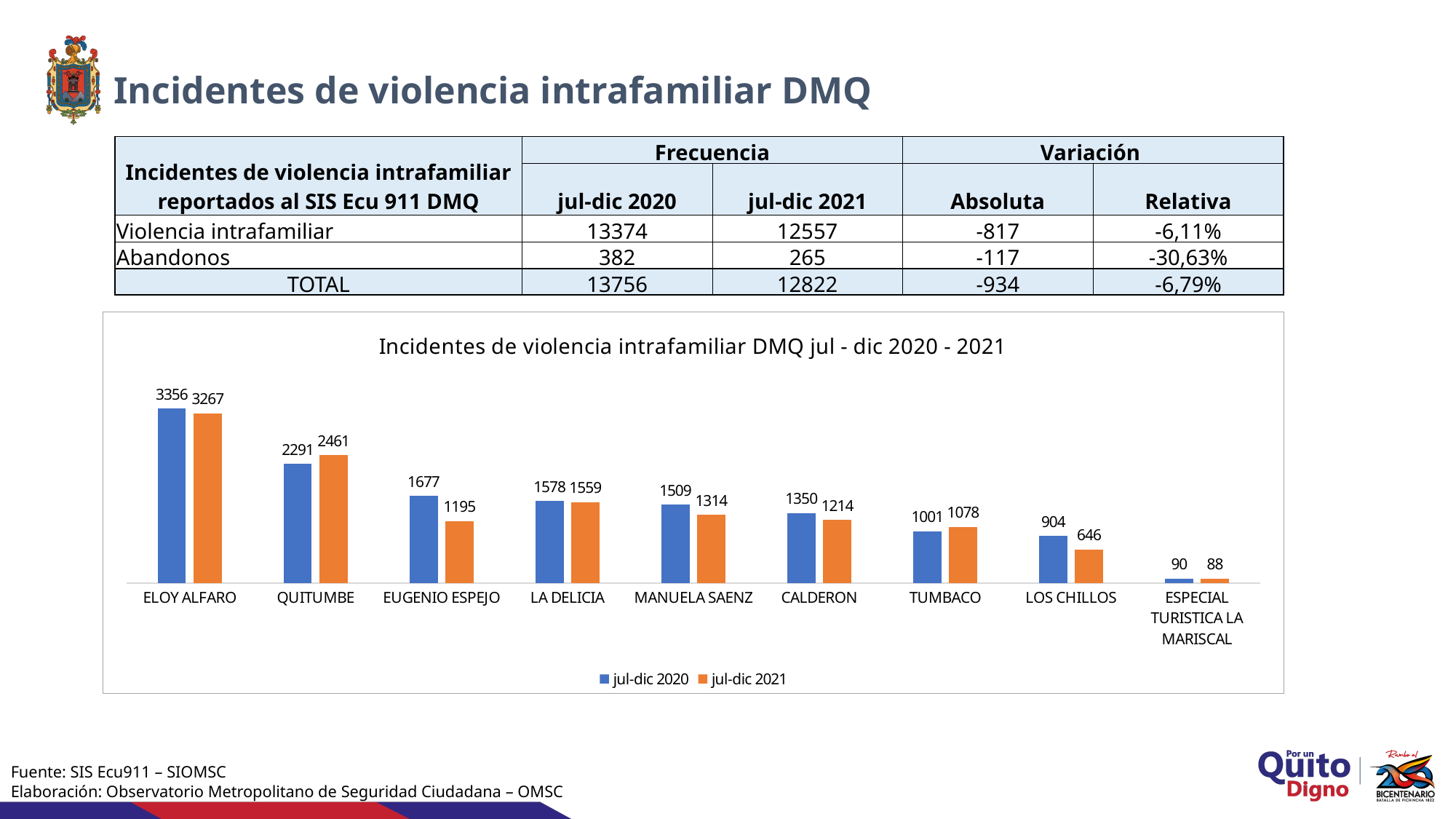
How many categories are shown on the x axis of the chart? 9 What is the jul-dic 2021 value for EUGENIO ESPEJO? 1195 What is the title of the chart? Incidentes de violencia intrafamiliar DMQ jul - dic 2020 - 2021 What is the difference between the jul-dic 2021 values for QUITUMBE and CALDERON? 1247 What is the difference between the jul-dic 2020 and jul-dic 2021 values for EUGENIO ESPEJO? 482 What kind of chart is shown on the slide? bar chart What is the jul-dic 2020 value for ELOY ALFARO? 3356 For QUITUMBE, which is larger: the jul-dic 2020 value or the jul-dic 2021 value? jul-dic 2021 How many series does the chart legend list? 2 What is the jul-dic 2021 value for LOS CHILLOS? 646 Which category has the lowest jul-dic 2020 value? ESPECIAL TURISTICA LA MARISCAL Which category has the highest jul-dic 2021 value? ELOY ALFARO